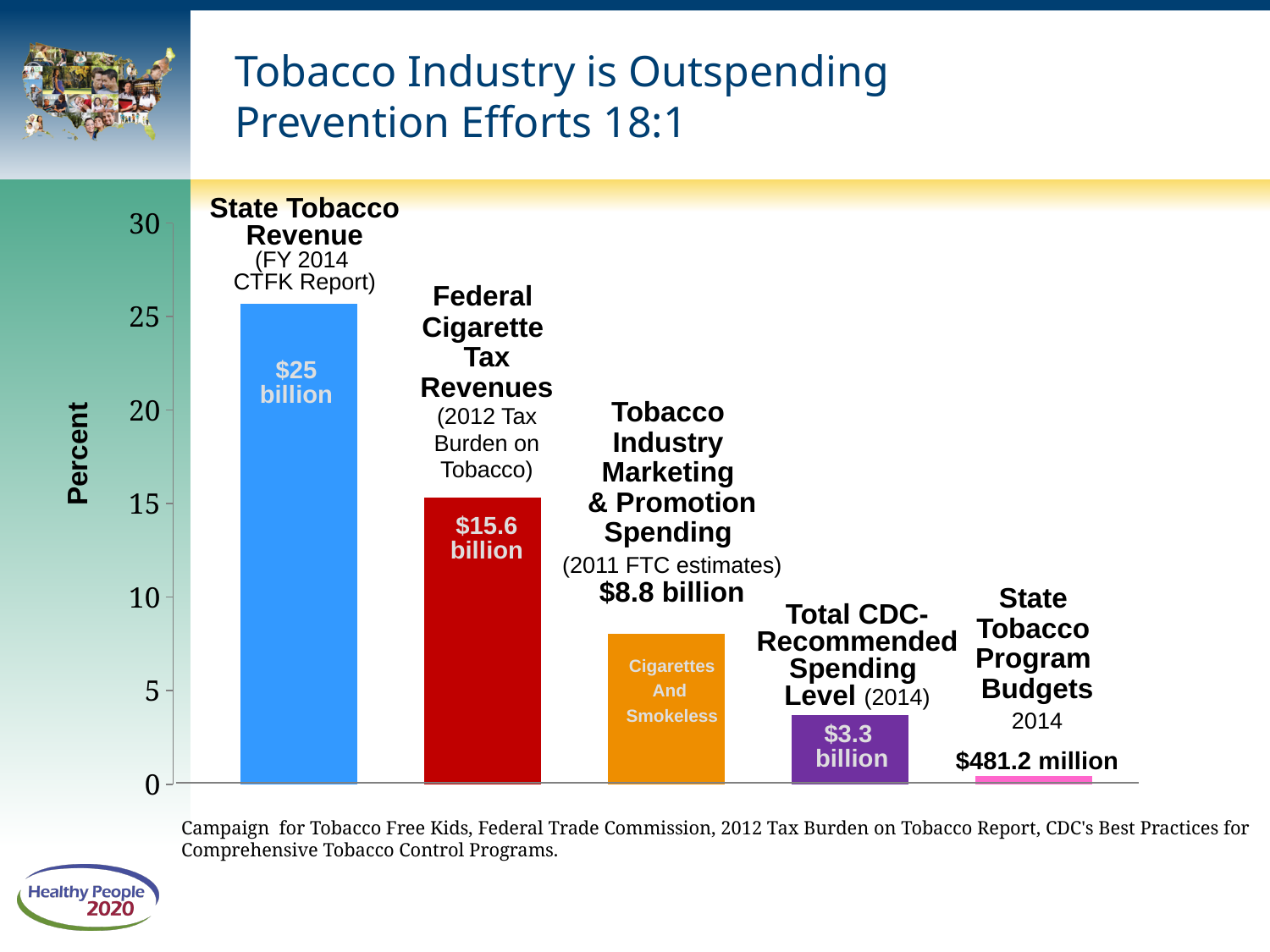
What value is shown for Tobacco Industry Marketing & Promotion Spending? $8.8 billion How many bars are plotted in the chart? 5 What value is shown for the Total CDC-Recommended Spending Level? $3.3 billion Which category has the highest bar? State Tobacco Revenue What value is shown for State Tobacco Revenue? $25 billion What value is shown for Federal Cigarette Tax Revenues? $15.6 billion Which category has the lowest bar? State Tobacco Program Budgets What is the difference between State Tobacco Revenue and Federal Cigarette Tax Revenues? $9.4 billion What kind of chart is shown on the slide? Bar chart Which is larger, Federal Cigarette Tax Revenues or Tobacco Industry Marketing & Promotion Spending? Federal Cigarette Tax Revenues What value is shown for State Tobacco Program Budgets in 2014? $481.2 million What is the difference between Tobacco Industry Marketing & Promotion Spending and the Total CDC-Recommended Spending Level? $5.5 billion